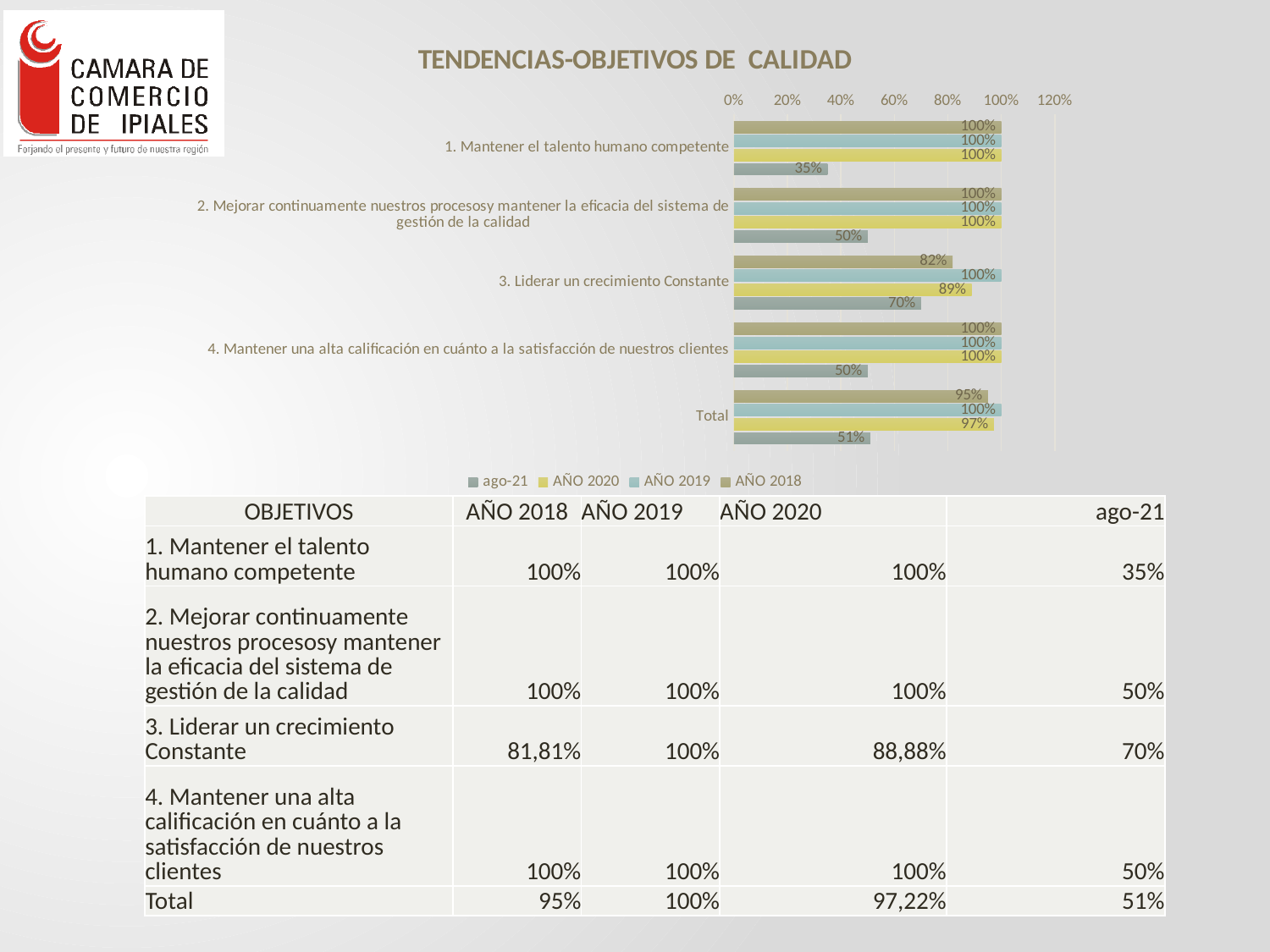
What is the AÑO 2020 value for 'Total' in the chart? 97% What is the ago-21 value for 'Total' in the chart? 51% What is the title of the chart? TENDENCIAS-OBJETIVOS DE CALIDAD What type of chart is shown on the slide? bar chart Which category has the lowest ago-21 value in the chart? 1. Mantener el talento humano competente How many series does the chart legend list? 4 How many categories are plotted on the chart? 5 Which is larger for '3. Liderar un crecimiento Constante': the AÑO 2018 value or the ago-21 value? AÑO 2018 What is the ago-21 value for '1. Mantener el talento humano competente' in the chart? 35% What is the difference between the AÑO 2019 and AÑO 2020 values for '3. Liderar un crecimiento Constante' in the chart? 11% Is the ago-21 value for '2. Mejorar continuamente nuestros procesosy mantener la eficacia del sistema de gestión de la calidad' greater or less than 80%? less What is the AÑO 2018 value for '3. Liderar un crecimiento Constante' in the chart? 82%